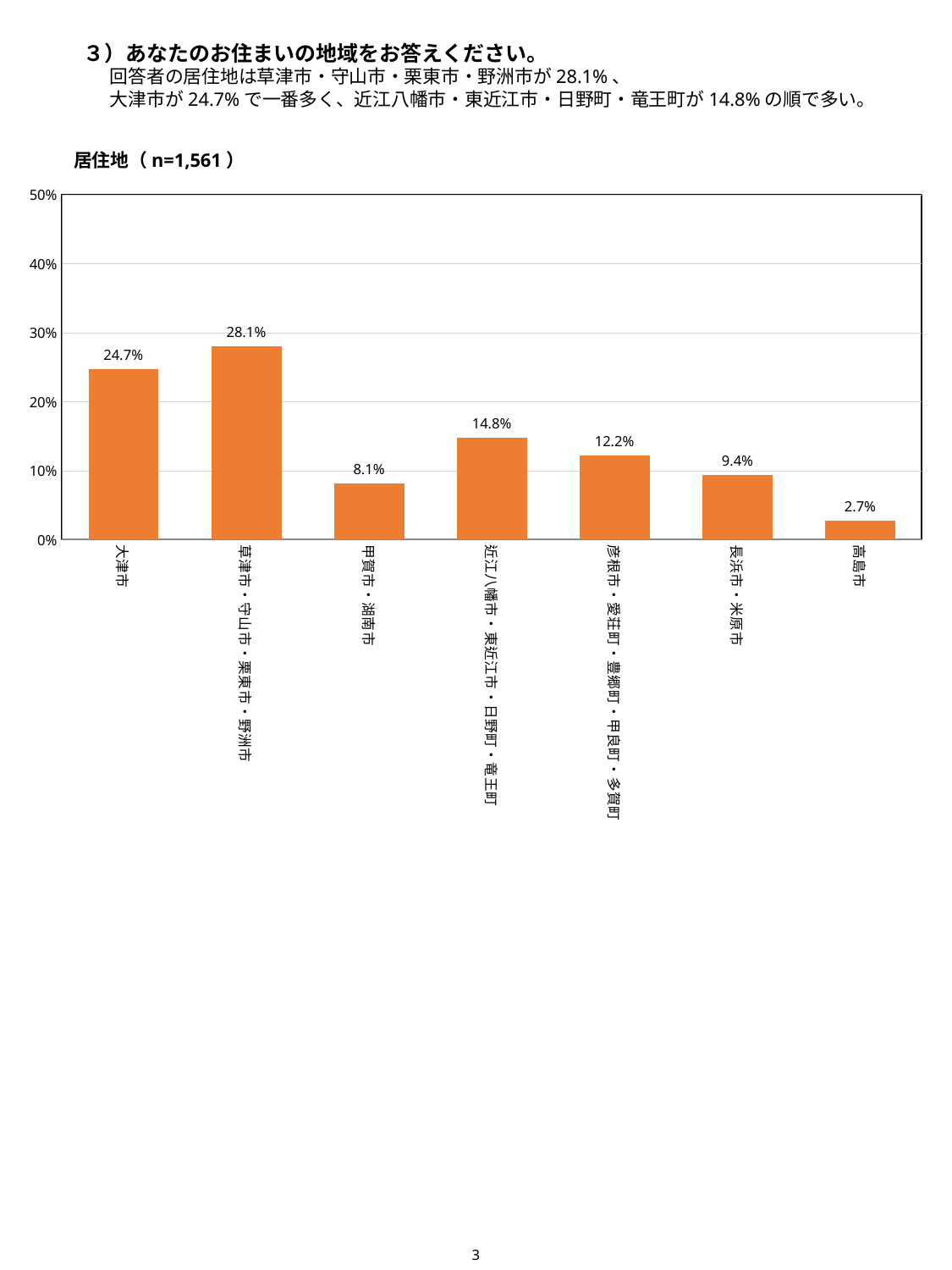
How many categories are shown on the x axis? 7 What is the title of the chart? 居住地（ n=1,561 ） Which category has the highest value? 草津市・守山市・栗東市・野洲市 Which category has the lowest value? 高島市 What is the difference between the values for 草津市・守山市・栗東市・野洲市 and 大津市? 3.4% What kind of chart is shown? bar chart Is the value for 近江八幡市・東近江市・日野町・竜王町 greater or less than 10%? greater What is the value for 草津市・守山市・栗東市・野洲市? 28.1% Which is larger, the value for 彦根市・愛荘町・豊郷町・甲良町・多賀町 or the value for 長浜市・米原市? 彦根市・愛荘町・豊郷町・甲良町・多賀町 What is the value for 高島市? 2.7% What is the value for 甲賀市・湖南市? 8.1% What is the value for 大津市? 24.7%